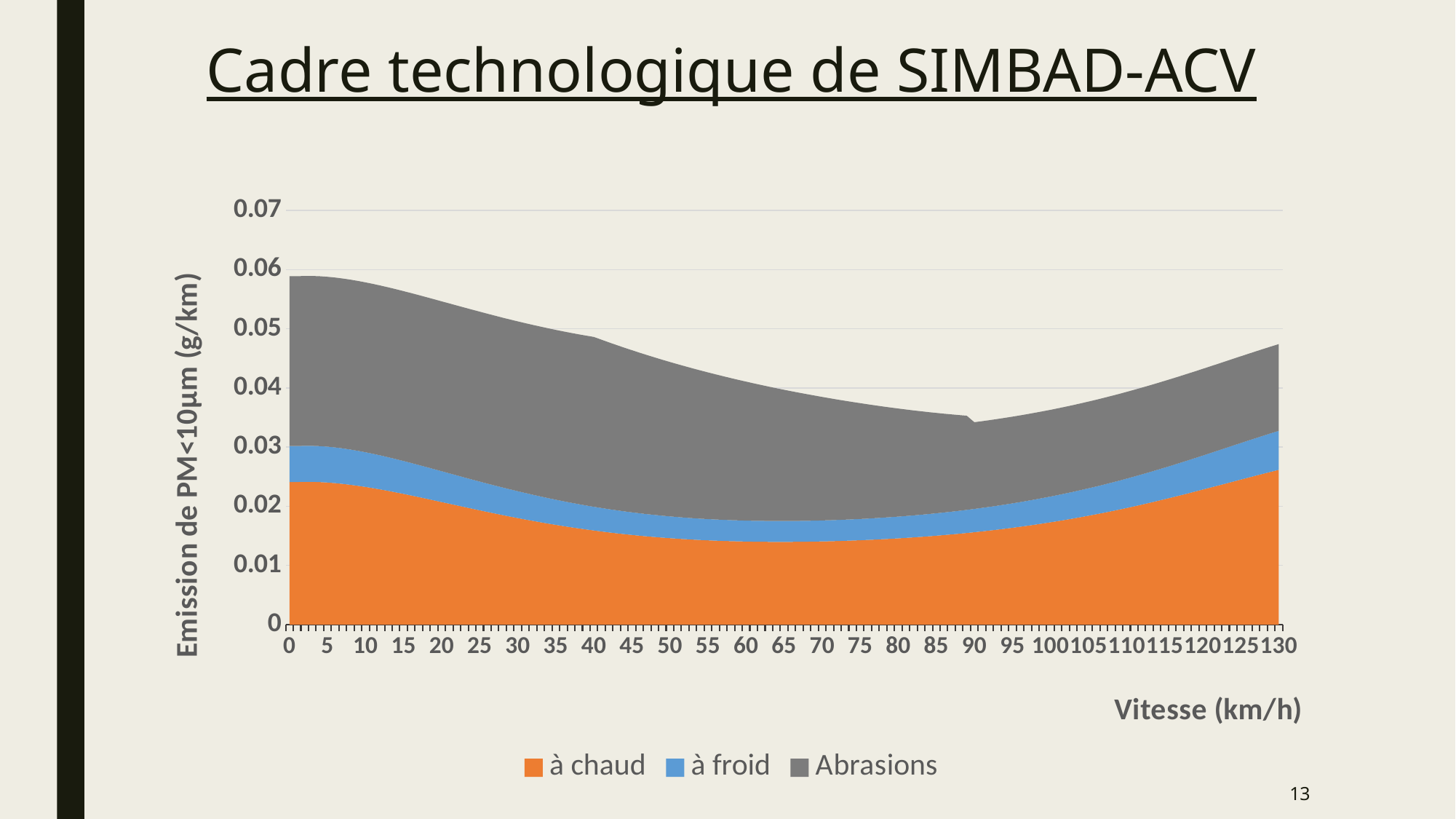
What is the label of the x axis? Vitesse (km/h) Is the total emission higher at 0 km/h or at 130 km/h? 0 km/h Is the 'à chaud' value at 60 km/h greater or less than 0.02 g/km? less What are the three series named in the legend? à chaud, à froid, Abrasions Is the total emission at a speed of 0 km/h greater or less than 0.05 g/km? greater Is the total emission at a speed of 90 km/h greater or less than 0.04 g/km? less How many series does the legend list? 3 Which series contributes the smallest share of emissions across the speed range? à froid At 60 km/h, which series is larger: 'Abrasions' or 'à chaud'? Abrasions How does the total emission change as speed increases from 0 to 90 km/h? It falls What kind of chart is shown on the slide? Stacked area chart